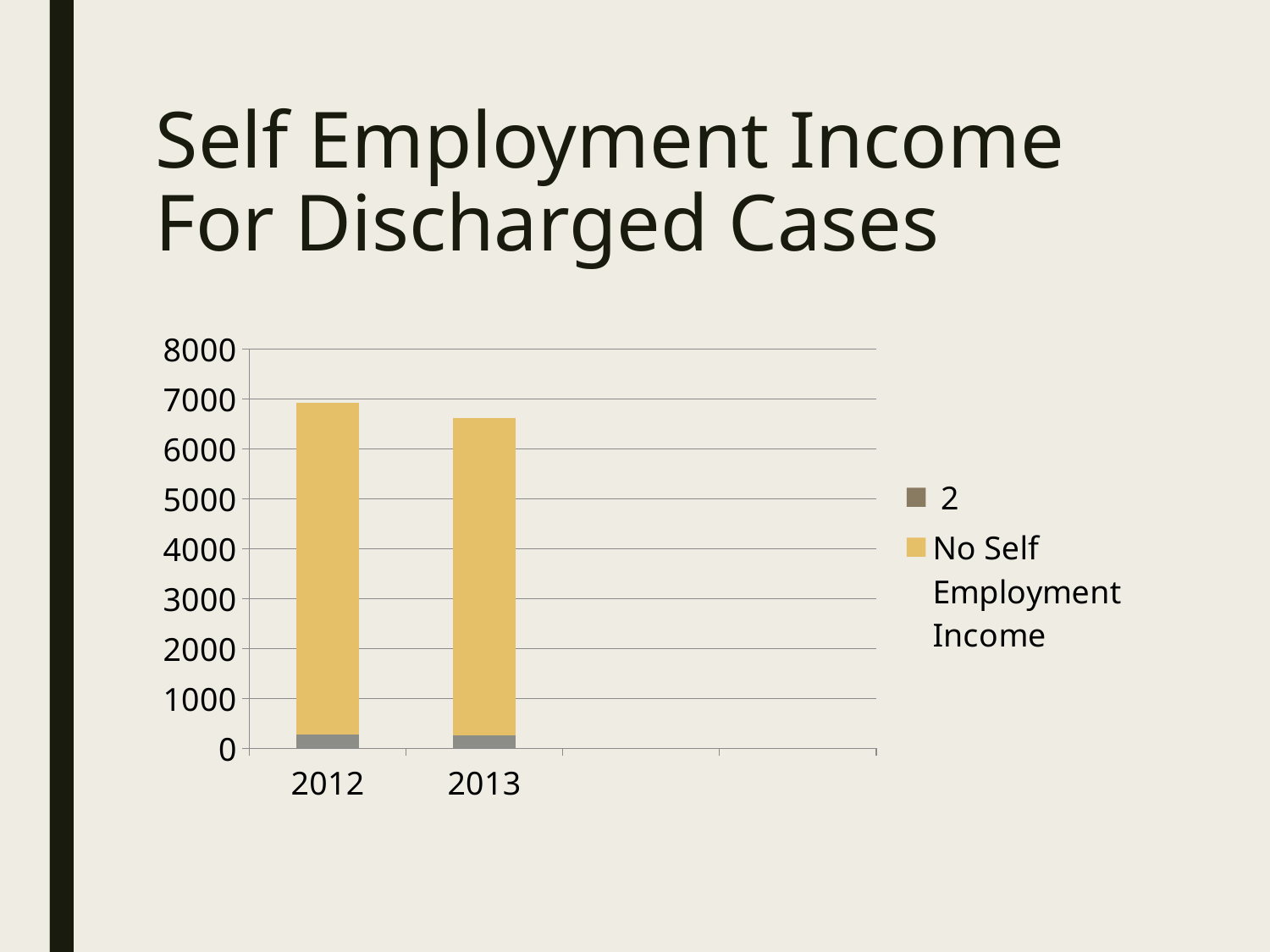
Is the total height of the 2012 bar greater or less than 7000? less Is the total height of the 2013 bar greater or less than 6000? greater What is the title of the slide containing the chart? Self Employment Income For Discharged Cases Is the value of the '2' series for 2012 greater or less than 1000? less Which year has the taller stacked bar, 2012 or 2013? 2012 What kind of chart is shown on the slide? stacked bar chart Does the total bar height rise or fall from 2012 to 2013? fall How many years are shown on the x axis of the chart? 2 Which series is shown in yellow in the chart? No Self Employment Income How many series does the chart's legend list? 2